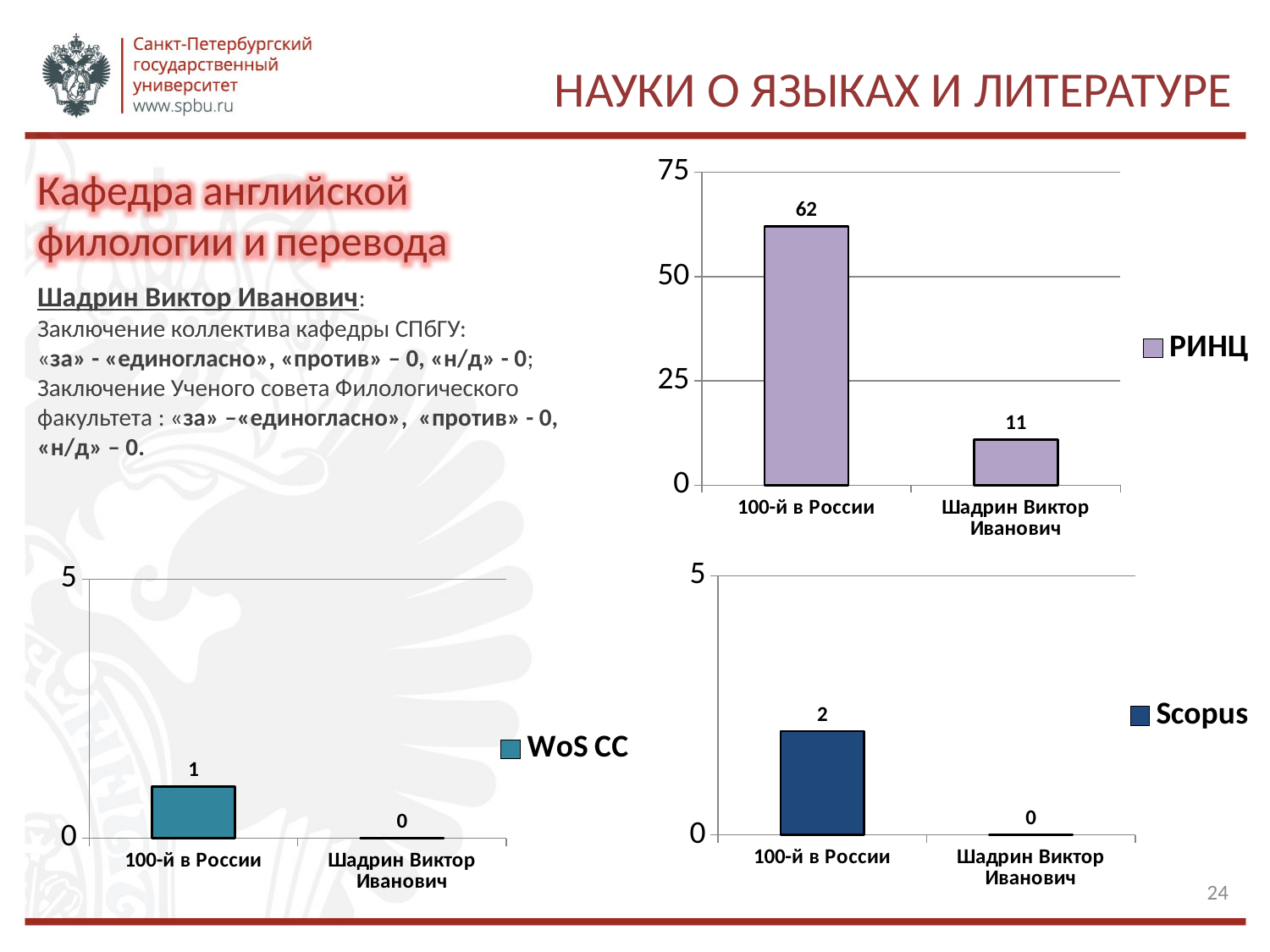
How many categories are shown on the x axis of the Scopus chart (bottom right)? 2 In the WoS CC chart (bottom left), what is the value for Шадрин Виктор Иванович? 0 What kind of chart is the РИНЦ chart (top right)? bar chart In the РИНЦ chart (top right), what is the value for «100-й в России»? 62 In the РИНЦ chart (top right), what is the value for Шадрин Виктор Иванович? 11 In the Scopus chart (bottom right), what is the value for «100-й в России»? 2 In the WoS CC chart (bottom left), what is the value for «100-й в России»? 1 In the РИНЦ chart (top right), what is the difference between the value for «100-й в России» and the value for Шадрин Виктор Иванович? 51 In the Scopus chart (bottom right), which category has the lower value? Шадрин Виктор Иванович In the РИНЦ chart (top right), is the value for «100-й в России» greater or less than 50? greater In the РИНЦ chart (top right), which category has the higher value? 100-й в России In the Scopus chart (bottom right), what is the value for Шадрин Виктор Иванович? 0